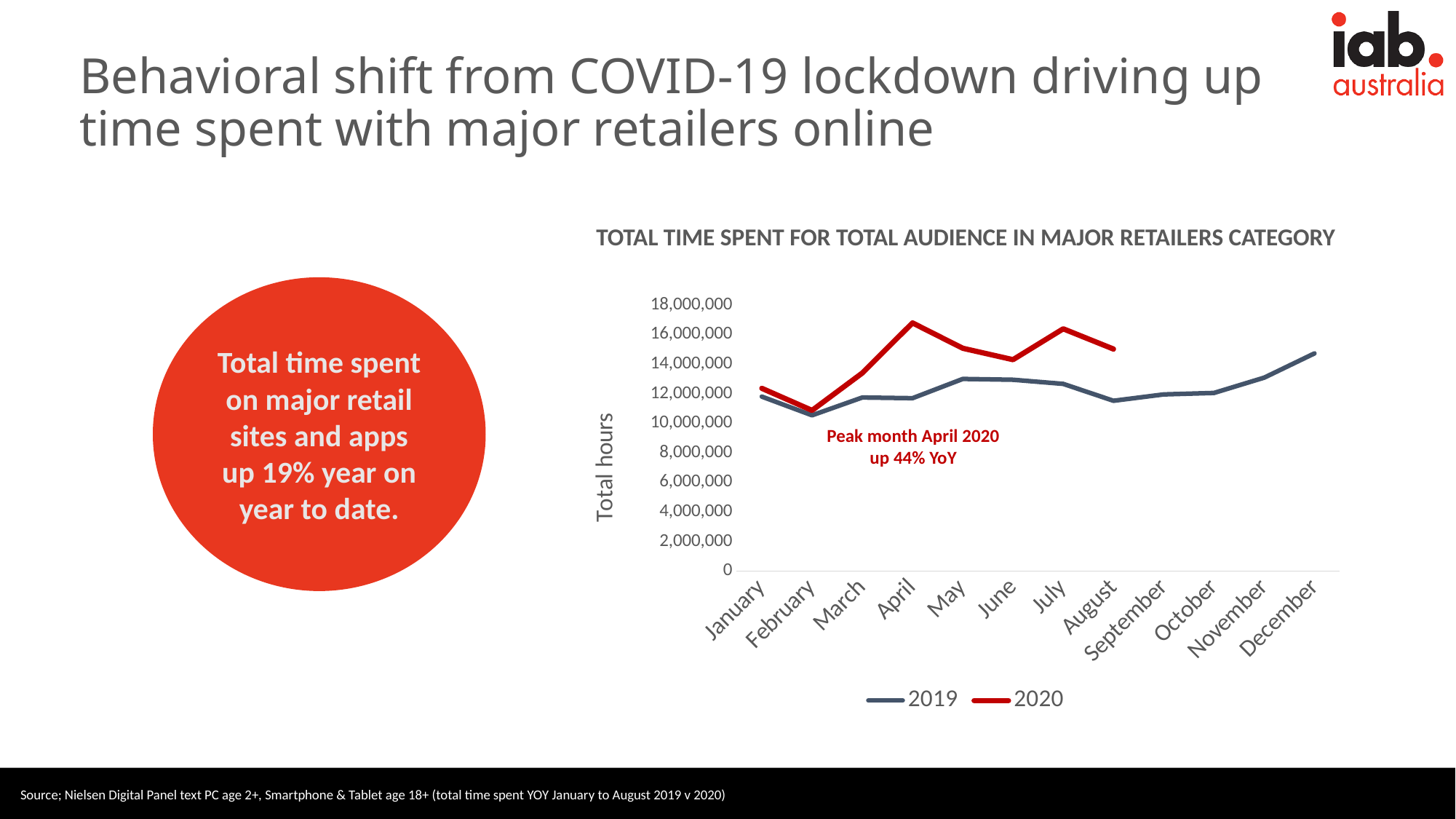
Is the value for 2019 in February greater or less than 12,000,000? less In which month does the 2020 series reach its highest value? April Which series has the larger value in July, 2019 or 2020? 2020 In which month is the 2019 series at its lowest value? February Is the value for 2020 in April greater or less than 16,000,000? greater What is the label on the y axis of the chart? Total hours In which month does the 2019 series reach its highest value? December How many months are shown along the x axis? 12 What kind of chart is shown on the slide? Line chart In which month is the 2020 series at its lowest value? February How many series does the legend list? 2 Does the 2019 series rise or fall from August to December? Rise